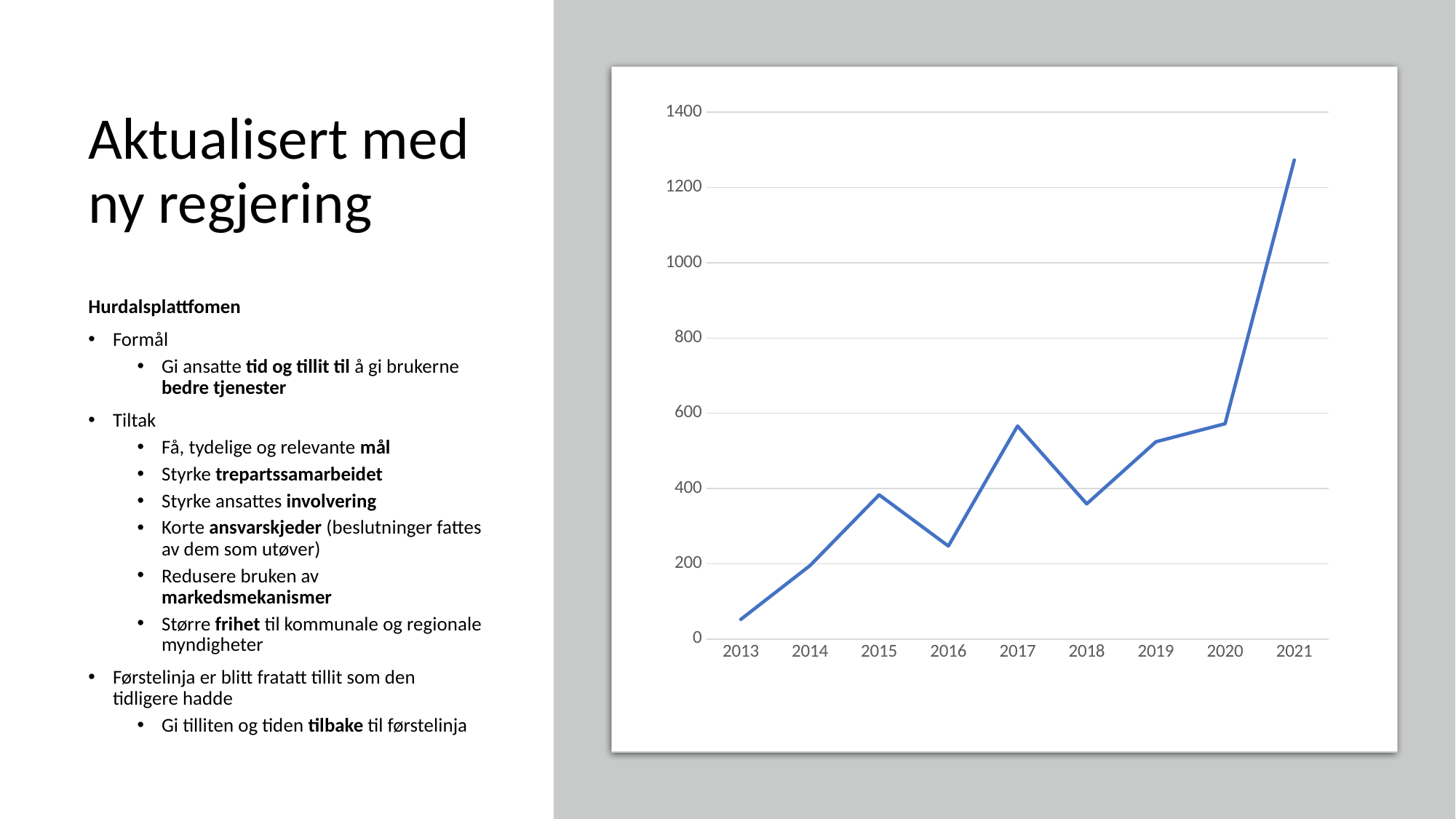
Which year has the lowest value in the chart? 2013 Which year has the highest value in the chart? 2021 Is the value for 2021 greater or less than 1200? greater Is the value for 2017 greater or less than 400? greater Is the value for 2018 greater or less than 400? less What kind of chart is shown on the slide? line chart How many years are plotted on the x axis of the chart? 9 Does the line rise or fall between 2020 and 2021? rise Which is larger, the value for 2014 or the value for 2015? 2015 Which is larger, the value for 2016 or the value for 2018? 2018